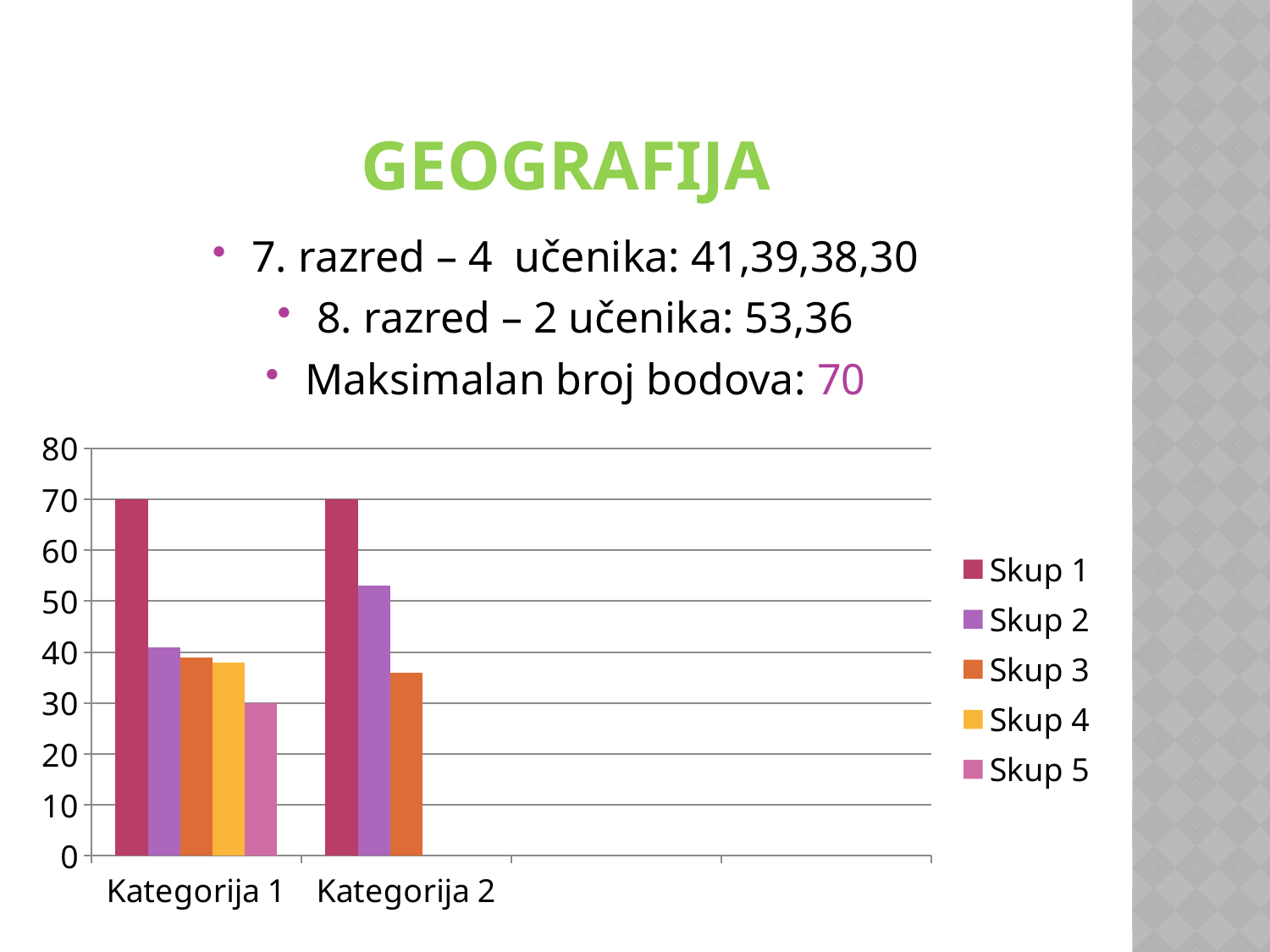
How many series does the legend list? 5 What is the difference between Skup 1 and Skup 5 in Kategorija 1? 40 Is the value for Skup 3 in Kategorija 2 greater or less than 40? less What kind of chart is shown on the slide? bar chart Which series has the highest value in Kategorija 2? Skup 1 How many series have a bar plotted for Kategorija 2? 3 What is the value of Skup 5 for Kategorija 1? 30 What is the value of Skup 1 for Kategorija 1? 70 Is the value for Skup 2 in Kategorija 2 greater or less than 50? greater In Kategorija 2, which is larger: Skup 2 or Skup 3? Skup 2 Which series has the lowest value in Kategorija 1? Skup 5 How many categories are shown on the x axis? 2